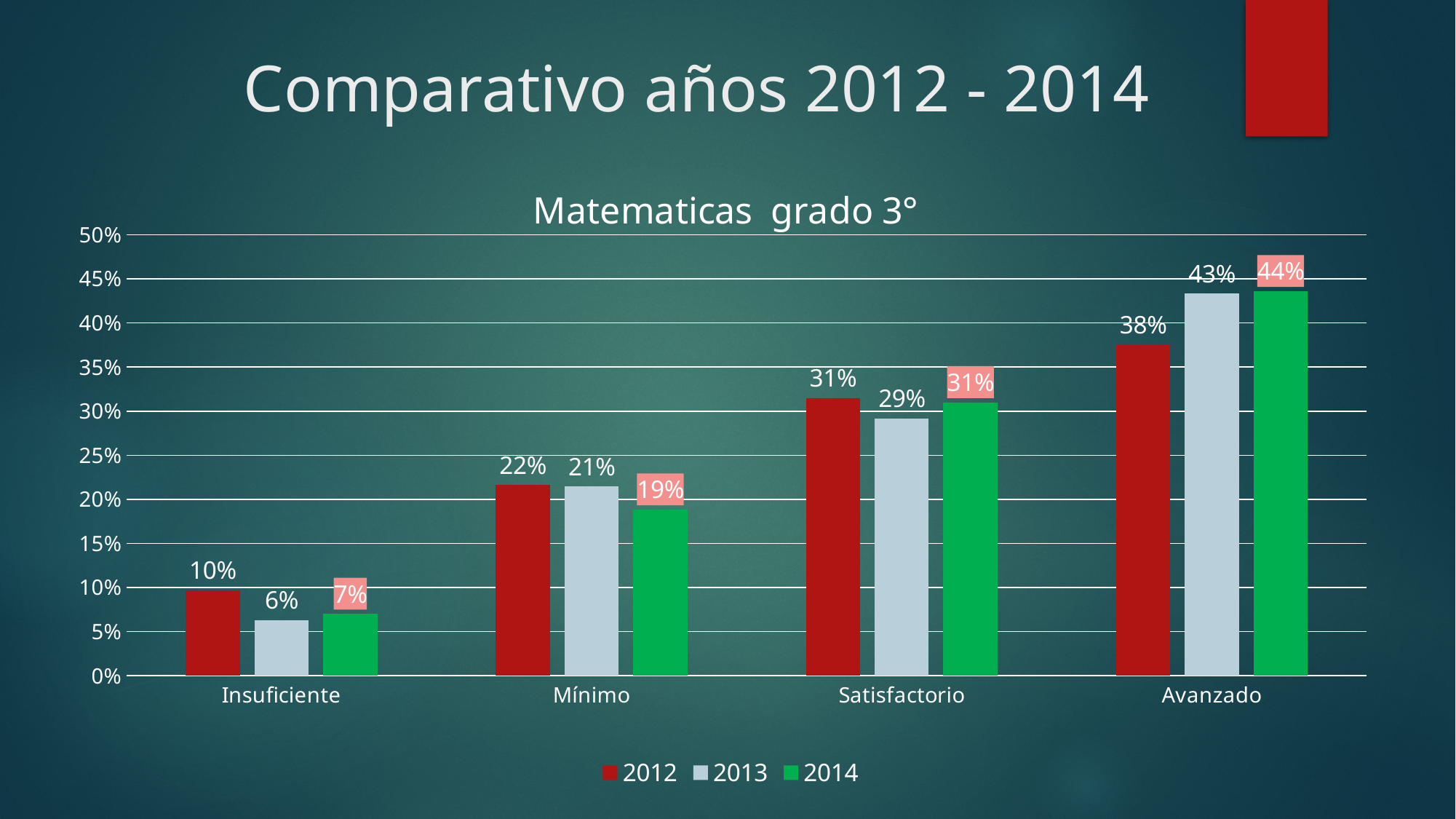
What is the value for 2014 in the Mínimo category? 19% What kind of chart is shown on the slide? Bar chart How many categories are shown on the x axis? 4 How many series does the legend list? 3 Which category has the highest value for the 2014 series? Avanzado What is the value for 2013 in the Avanzado category? 43% What is the title of the chart? Matematicas grado 3° Which category has the lowest value for the 2013 series? Insuficiente Which is larger in the Satisfactorio category, the 2013 value or the 2014 value? 2014 Do the 2012 values rise or fall from Insuficiente to Avanzado? Rise What is the value for 2012 in the Insuficiente category? 10% What is the difference between the 2012 and 2014 values in the Avanzado category? 6%